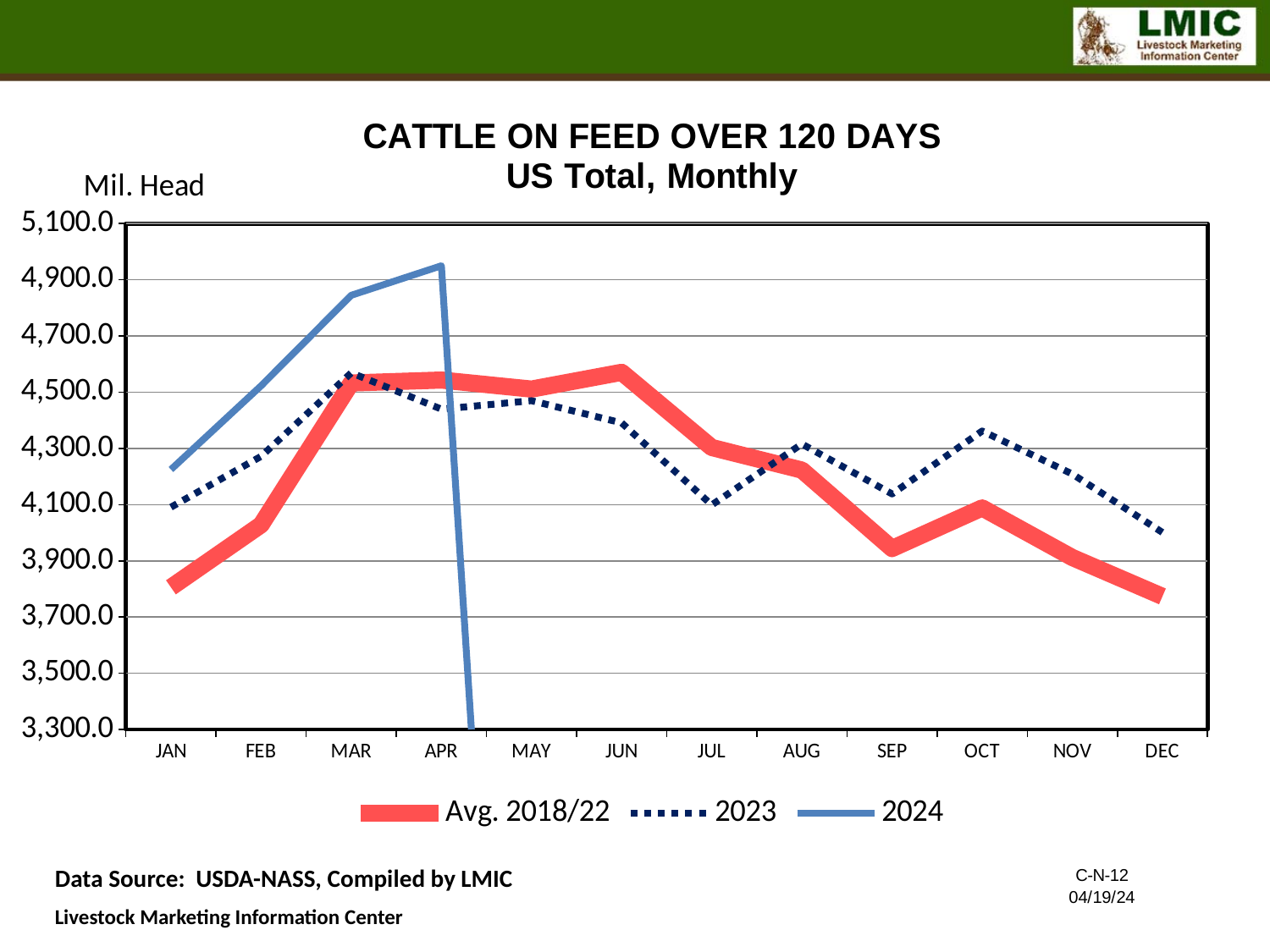
What unit label is shown above the y axis? Mil. Head Is the 2023 value for JUL greater or less than 4,300.0? less In which month does the 2023 series reach its highest value? MAR Is the 2024 value for MAR greater or less than 4,700.0? greater What kind of chart is shown on the slide? Line chart Is the 2023 value for JAN greater or less than 4,300.0? less Does the 2024 series rise or fall from JAN to APR? rise How many series does the legend list? 3 How many months are shown along the x axis? 12 Which is larger in JAN, the 2024 value or the Avg. 2018/22 value? 2024 Which is larger in DEC, the 2023 value or the Avg. 2018/22 value? 2023